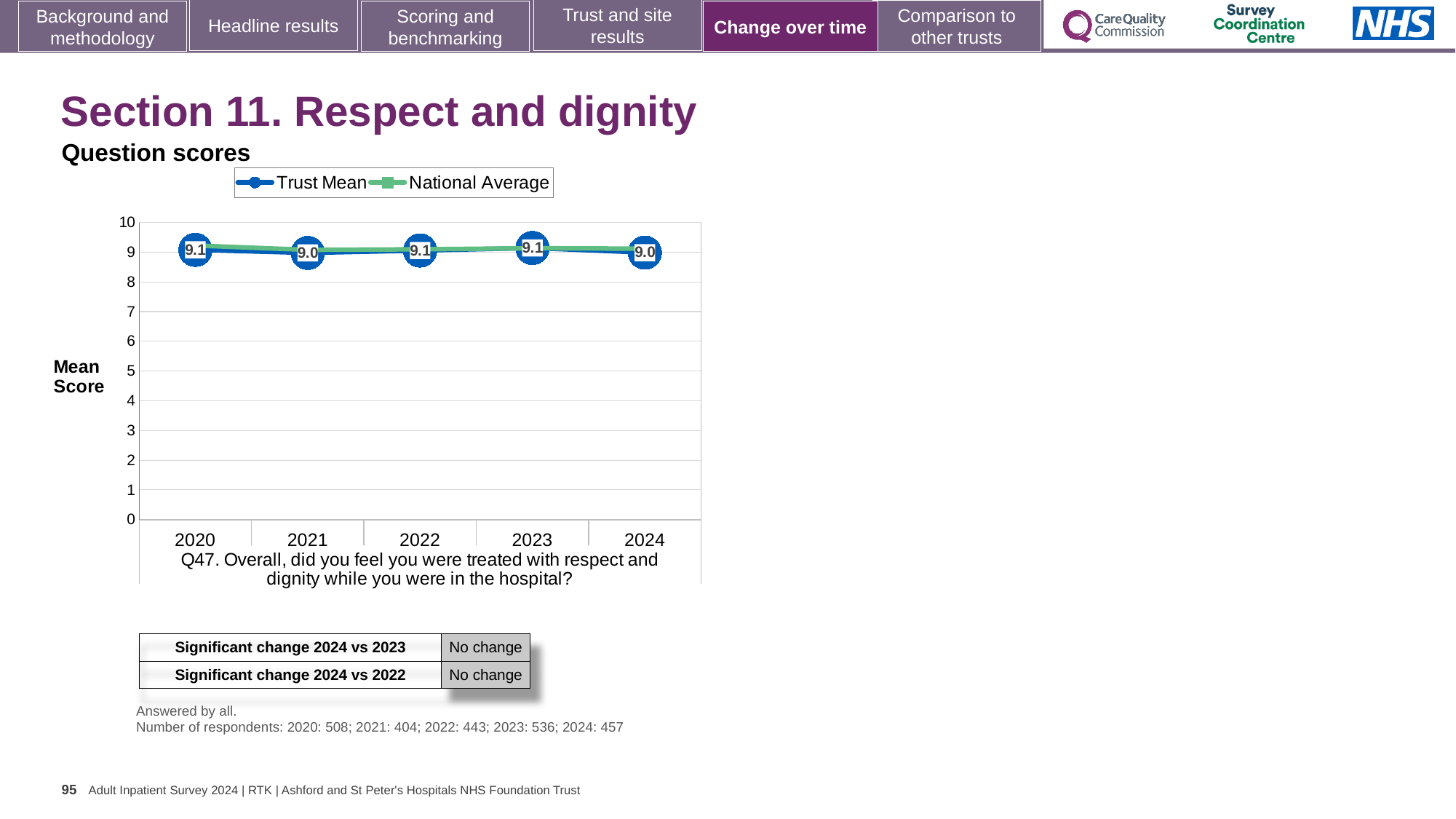
Which year has the larger Trust Mean score, 2023 or 2024? 2023 What is the difference between the Trust Mean scores for 2020 and 2021? 0.1 What is the Trust Mean score for 2020? 9.1 Does the Trust Mean score rise, fall, or stay roughly flat from 2020 to 2024? Roughly flat What kind of chart is shown on the slide? Line chart How many series does the legend list? 2 What is the Trust Mean score for 2024? 9.0 How many years are plotted on the x axis? 5 What is the Trust Mean score for 2023? 9.1 Is the National Average value for 2022 greater or less than 8? greater What is the Trust Mean score for 2021? 9.0 What is the label of the y axis? Mean Score